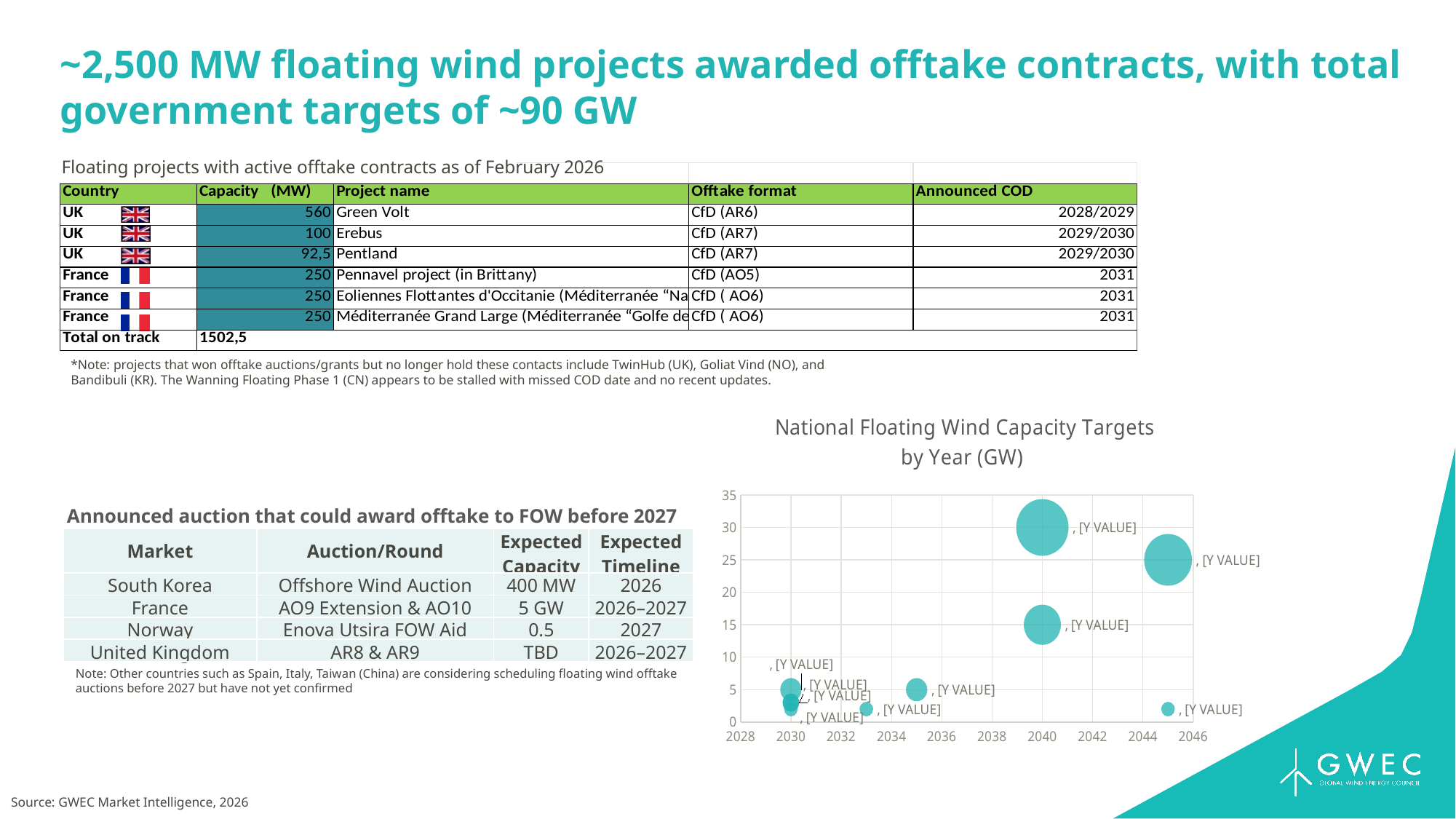
In the National Floating Wind Capacity Targets chart, which has the larger value: the top bubble at 2040 or the bubble at 2045? the top bubble at 2040 In the National Floating Wind Capacity Targets chart, what range of years does the x axis cover? 2028 to 2046 In the National Floating Wind Capacity Targets chart, which has the larger value: the bubble at 2035 or the bubble at 2033? 2035 In the National Floating Wind Capacity Targets chart, is the value of the bubble at 2035 greater or less than 10? less In the National Floating Wind Capacity Targets chart, is the value of the largest bubble (around 2040) greater or less than 25? greater In the National Floating Wind Capacity Targets chart, is the value of the lower bubble at 2040 greater or less than 20? less What kind of chart is 'National Floating Wind Capacity Targets by Year (GW)'? bubble chart What is the title of the chart on the right of the slide? National Floating Wind Capacity Targets by Year (GW) In the National Floating Wind Capacity Targets chart, which year has the bubble with the highest capacity target? 2040